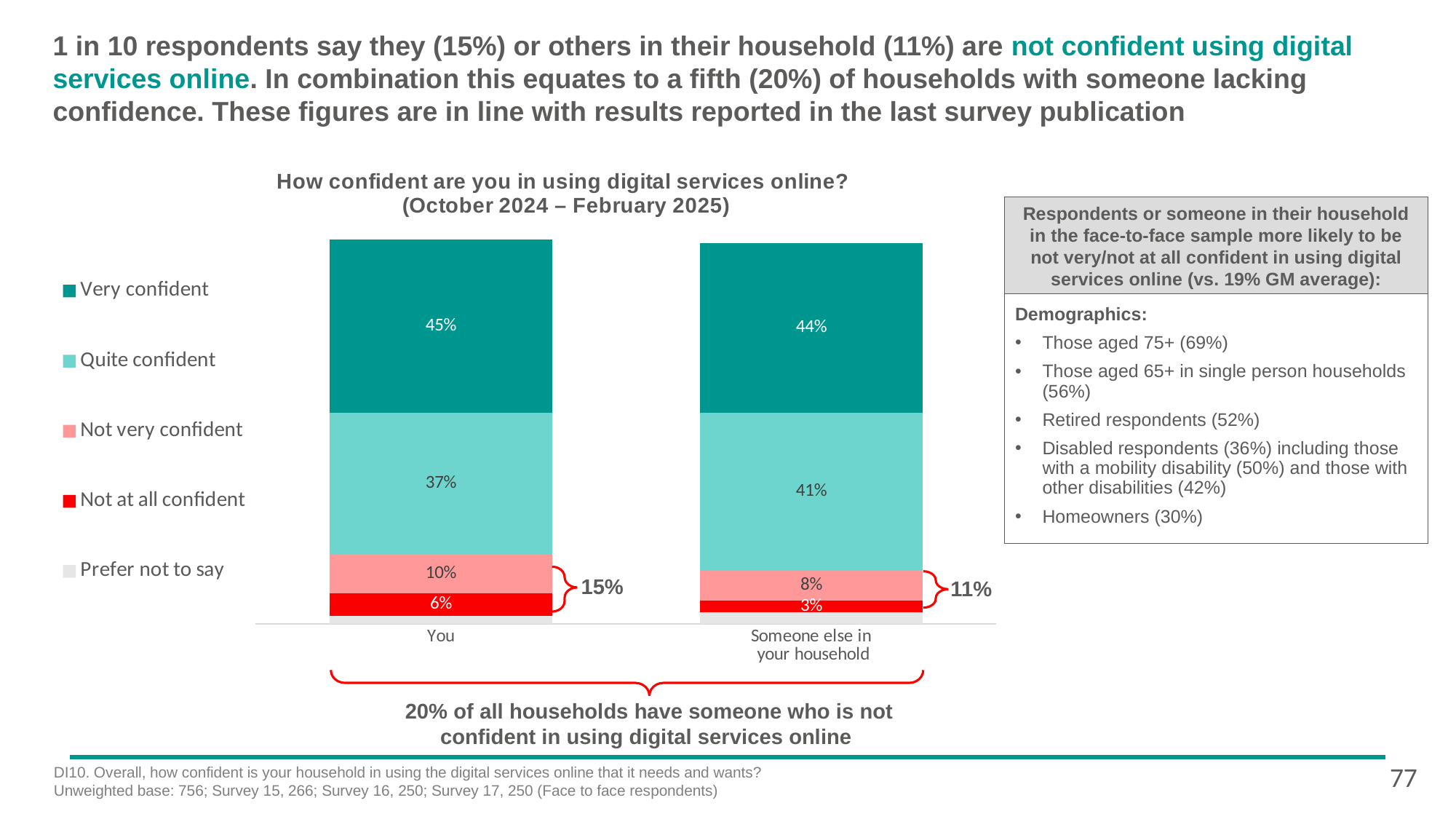
How many series does the chart legend list? 5 What is the title of the chart? How confident are you in using digital services online? (October 2024 – February 2025) What percentage is shown for 'Not at all confident' in the 'You' bar? 6% What percentage is shown for 'Quite confident' in the 'Someone else in your household' bar? 41% What combined percentage does the bracket show for 'Not very confident' and 'Not at all confident' in the 'Someone else in your household' bar? 11% What type of chart is shown on the slide? Stacked bar chart How many categories (bars) are shown on the x axis of the chart? 2 Which bar has the higher 'Not at all confident' value, 'You' or 'Someone else in your household'? You What is the difference between the 'Quite confident' values for 'You' and 'Someone else in your household'? 4% Which segment is the largest in the 'You' bar? Very confident What percentage is shown for 'Not very confident' in the 'Someone else in your household' bar? 8% What percentage of respondents say they are 'Very confident' for the 'You' bar? 45%